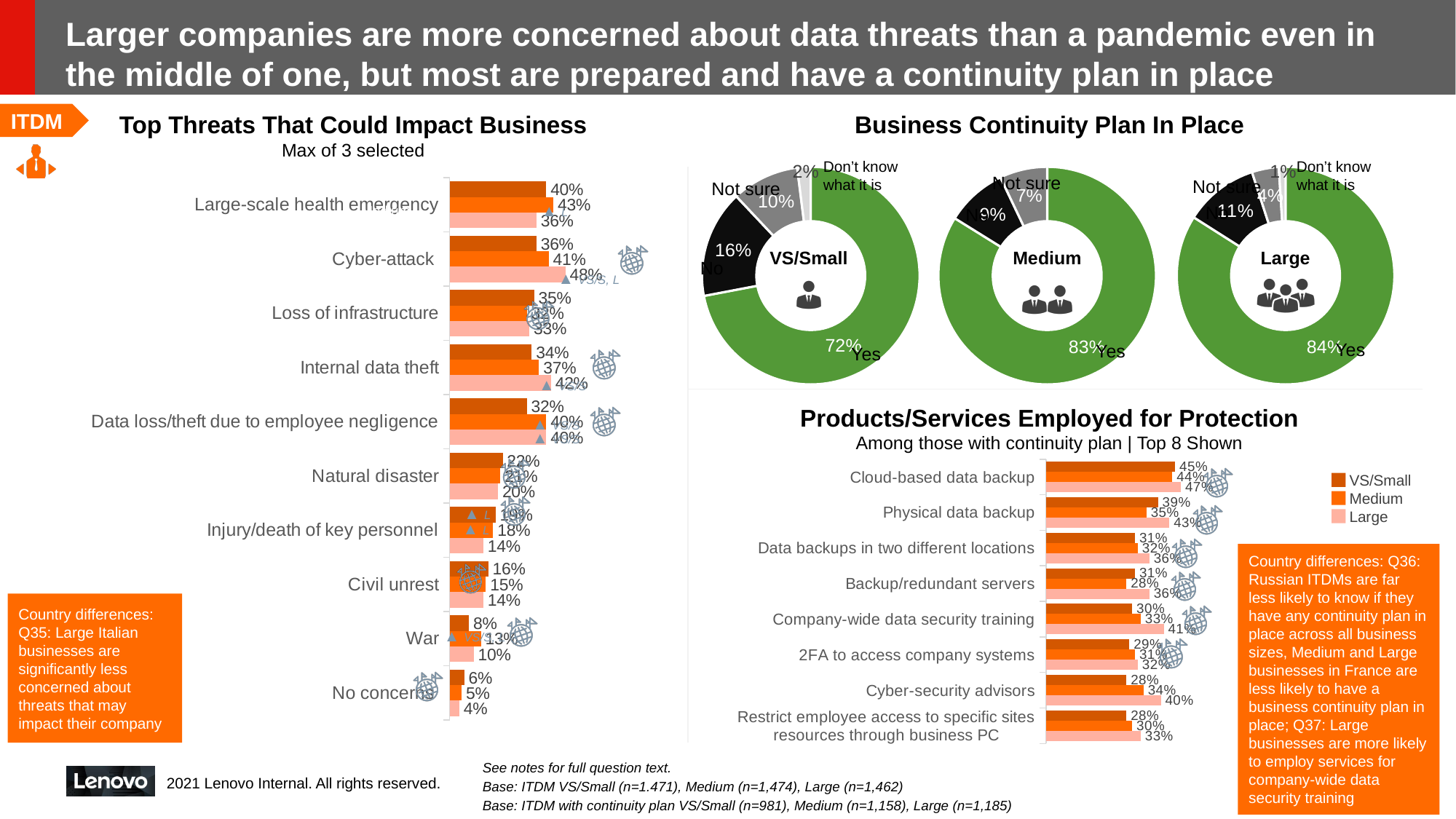
In the Products/Services Employed for Protection chart, how many series does the legend list? 3 In the Business Continuity Plan In Place chart, what percentage of Medium businesses answered No? 9% In the Business Continuity Plan In Place chart, which business size has the highest share answering Yes? Large In the Products/Services Employed for Protection chart, how many products/services are shown? 8 In the Products/Services Employed for Protection chart, what is the Large value for Cloud-based data backup? 47% In the Products/Services Employed for Protection chart, what is the VS/Small value for Physical data backup? 39% What type of chart is the Top Threats That Could Impact Business chart? Bar chart In the Products/Services Employed for Protection chart, which is larger for Cyber-security advisors: the Medium value or the Large value? Large In the Business Continuity Plan In Place chart, what percentage of VS/Small businesses answered Yes? 72% In the Top Threats That Could Impact Business chart, how many threat categories are listed? 10 In the Business Continuity Plan In Place chart, what is the difference between the Yes share for Medium and VS/Small businesses? 11 percentage points In the Business Continuity Plan In Place chart, what percentage of Large businesses answered Yes? 84%